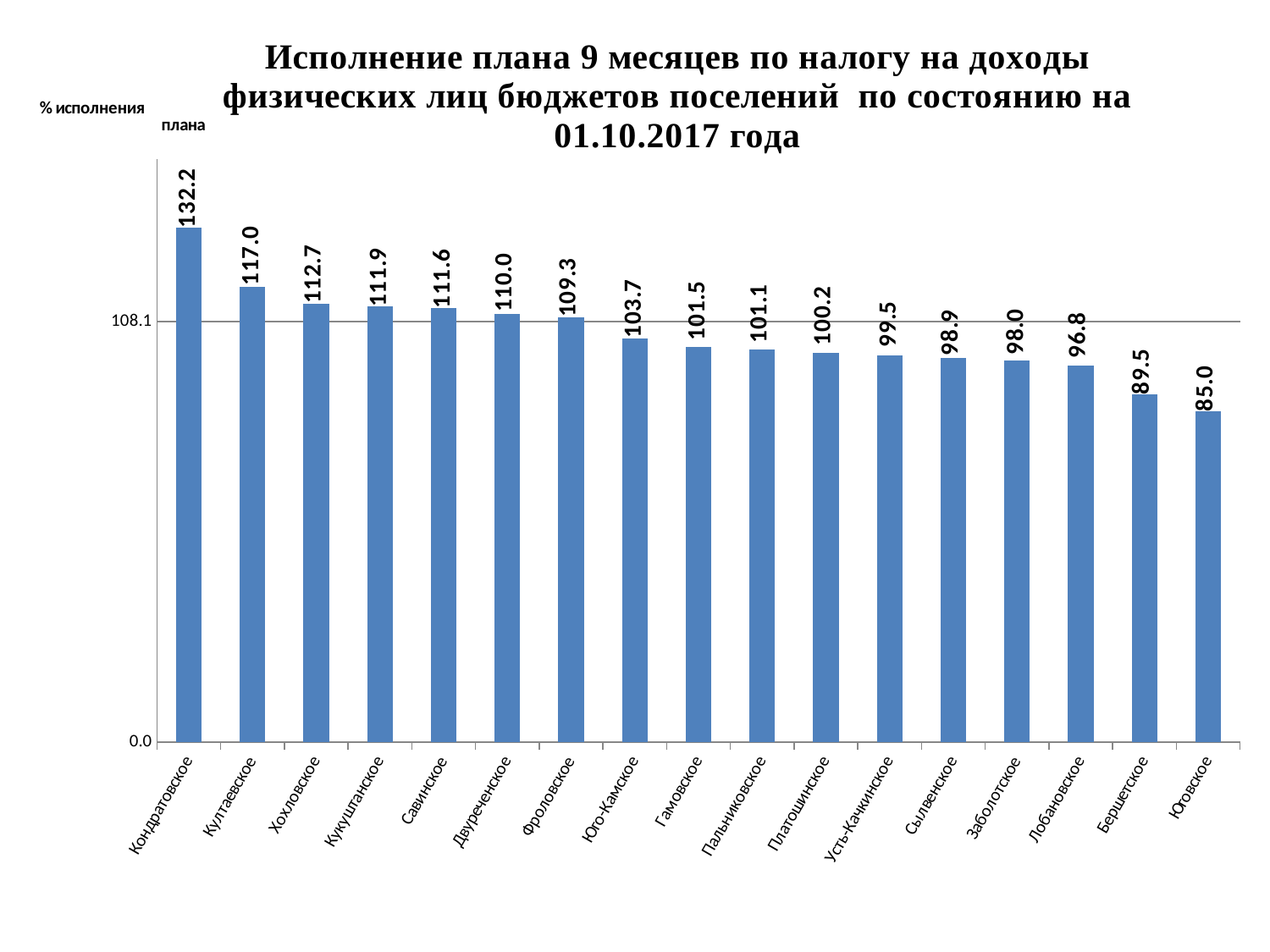
What is the difference between the values for Кондратовское and Юговское? 47.2 Which is larger, the value for Хохловское or the value for Гамовское? Хохловское What is the value for Кондратовское? 132.2 What is the value for Двуреченское? 110.0 What kind of chart is shown on the slide? Bar chart Which category has the lowest value? Юговское What is the difference between the values for Култаевское and Бершетское? 27.5 Do the values rise or fall from left to right along the x axis? Fall What is the value for Юго-Камское? 103.7 What is the value for Лобановское? 96.8 How many categories are shown on the chart? 17 Which category has the highest value? Кондратовское